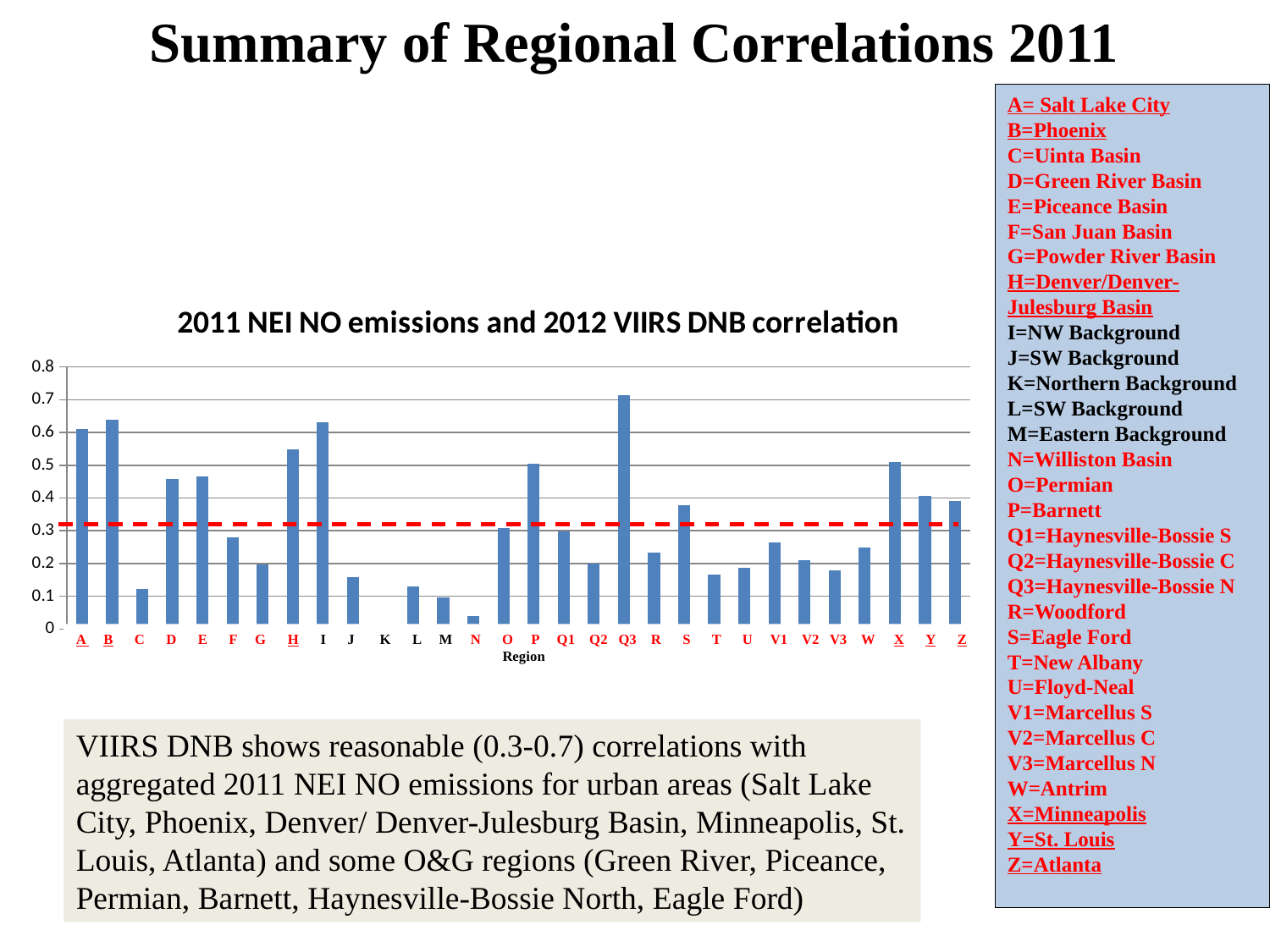
What kind of chart is shown on the slide? bar chart What is the title of the chart? 2011 NEI NO emissions and 2012 VIIRS DNB correlation Is the value for region N greater or less than 0.1? less Is the value for region A greater or less than 0.5? greater Which region has the highest correlation value in the chart? Q3 Is the value for region H greater or less than 0.5? greater Which has the larger value, region Q3 or region P? Q3 How many region categories are listed along the x axis of the chart? 30 What is the label of the x axis of the chart? Region Which has the larger value, region H or region I? I